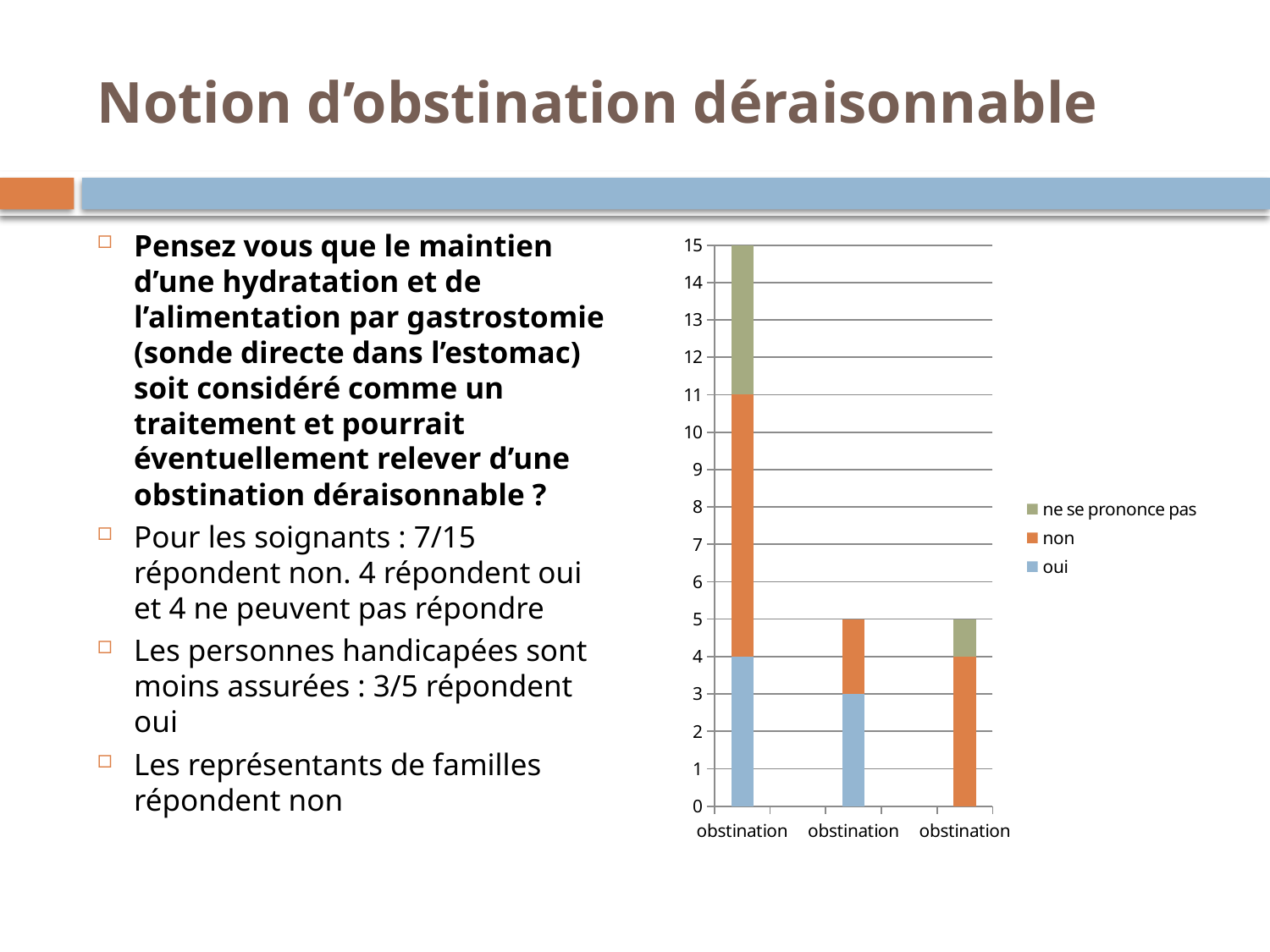
What is the total height of the leftmost bar in the chart? 15 Is the total of the leftmost bar greater or less than 10? greater What is the total height of the rightmost bar in the chart? 5 What is the value of the 'non' segment in the rightmost bar? 4 What is the total height of the middle bar in the chart? 5 What is the value of the 'oui' segment in the leftmost bar? 4 Which legend entry is shown in green? ne se prononce pas What is the value of the 'oui' segment in the middle bar? 3 Which bar has the greatest total height? the leftmost bar How many series does the chart legend list? 3 What kind of chart is shown on the slide? stacked bar chart How many bars are plotted in the chart? 3